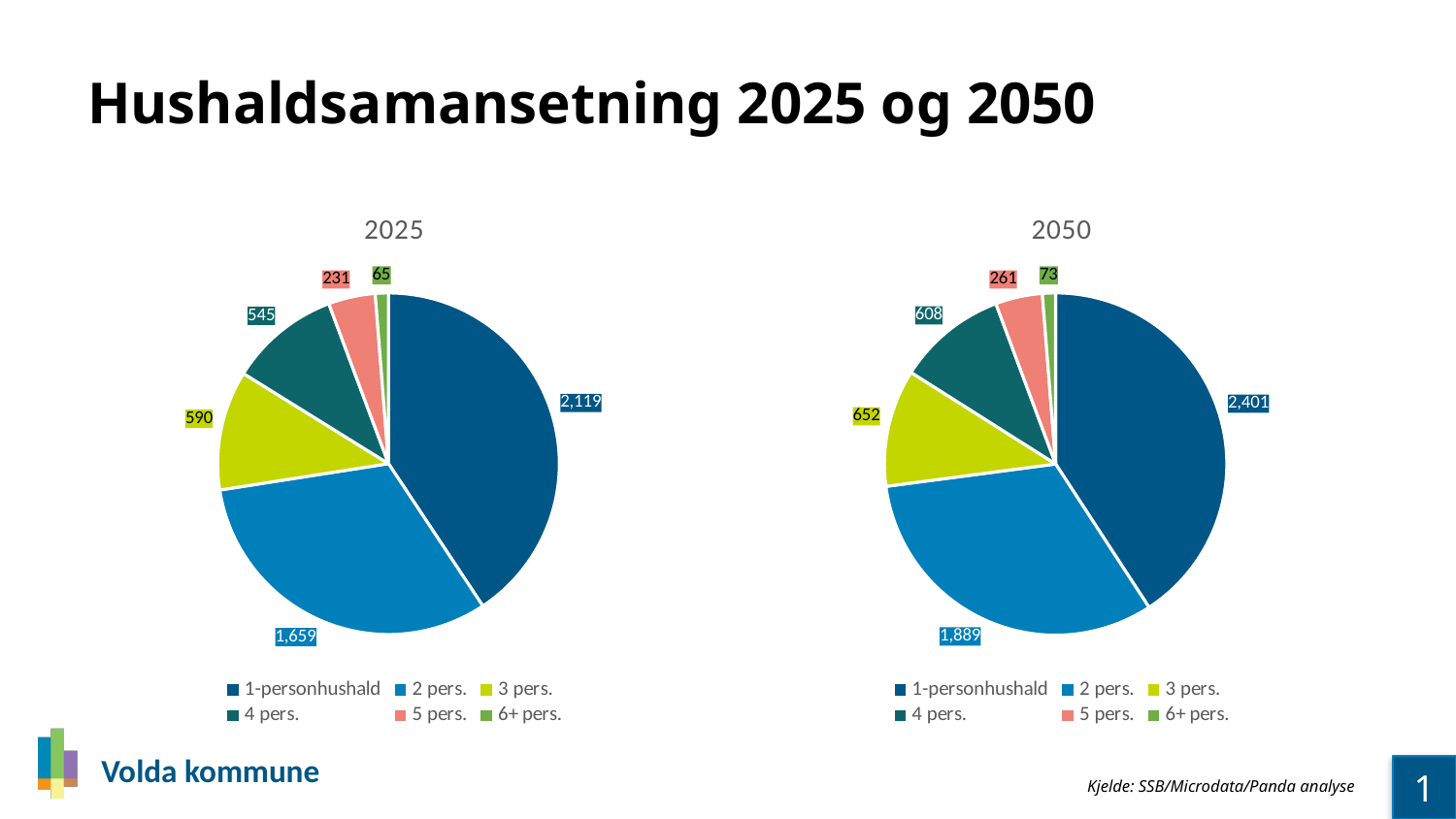
In the 2025 chart, what is the value for 1-personhushald? 2,119 What is the title of the chart on the left? 2025 In the 2050 chart, which is larger: 3 pers. or 4 pers.? 3 pers. In the 2025 chart, what is the value for 4 pers.? 545 In the 2025 chart, what is the difference between the values for 1-personhushald and 2 pers.? 460 In the 2050 chart, what is the value for 2 pers.? 1,889 What is the difference between the 1-personhushald value in the 2050 chart and in the 2025 chart? 282 In the 2050 chart, what is the value for 6+ pers.? 73 How many categories does the 2025 chart show? 6 In the 2025 chart, which category has the smallest slice? 6+ pers. In the 2050 chart, which category has the largest slice? 1-personhushald What kind of chart is the 2050 chart? Pie chart